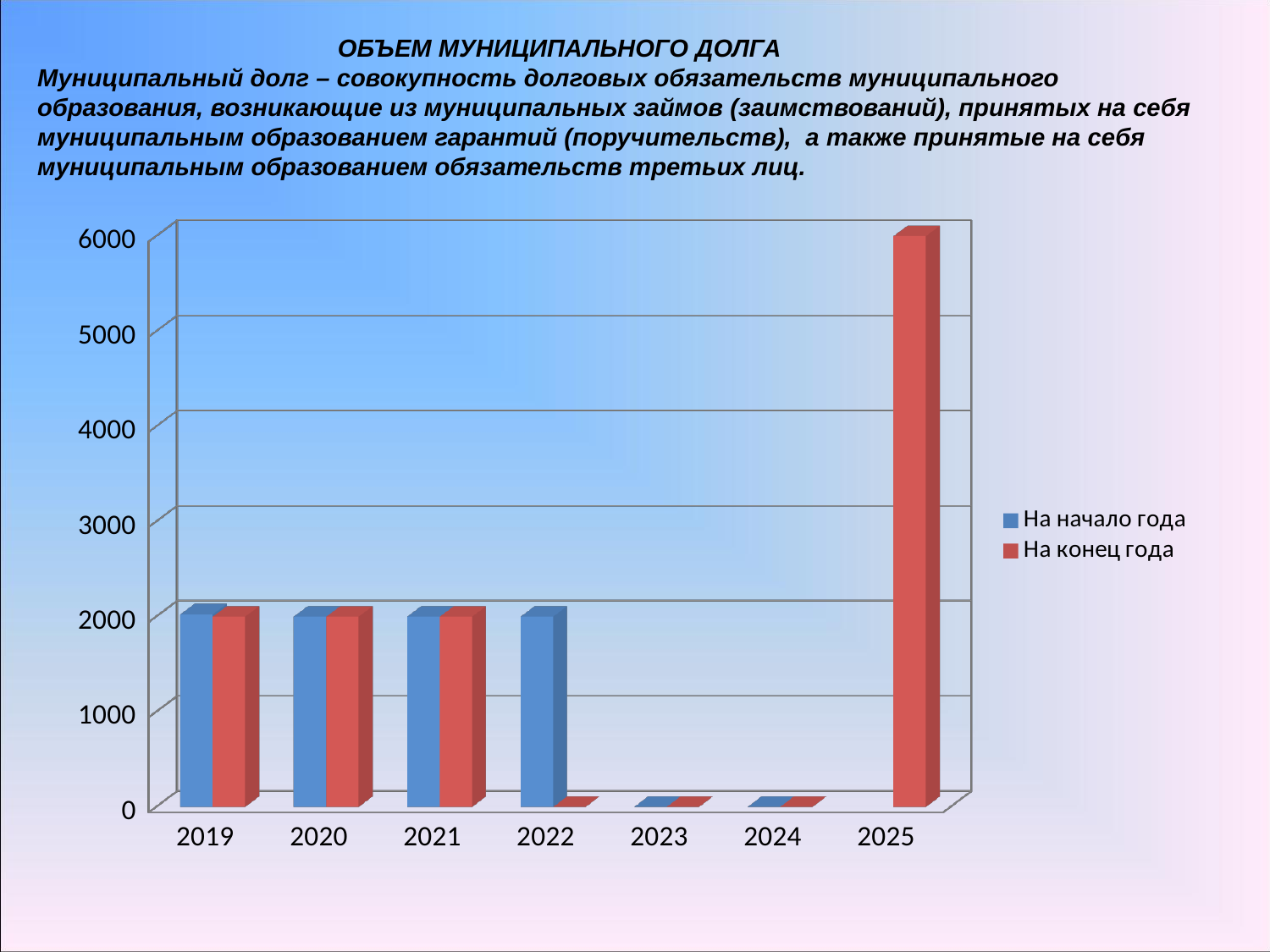
In 2022, which is larger: "На начало года" or "На конец года"? На начало года How many years are shown on the x axis? 7 What colour are the bars for "На конец года"? red Is the value for "На конец года" in 2022 greater or less than 1000? less What kind of chart is shown on the slide? bar chart Which is larger: "На конец года" in 2025 or "На конец года" in 2019? 2025 How many series does the legend list? 2 Which year has the highest value for "На конец года"? 2025 Is the value for "На конец года" in 2021 greater or less than 3000? less Is the value for "На начало года" in 2019 greater or less than 1000? greater What are the two entries in the legend? На начало года, На конец года